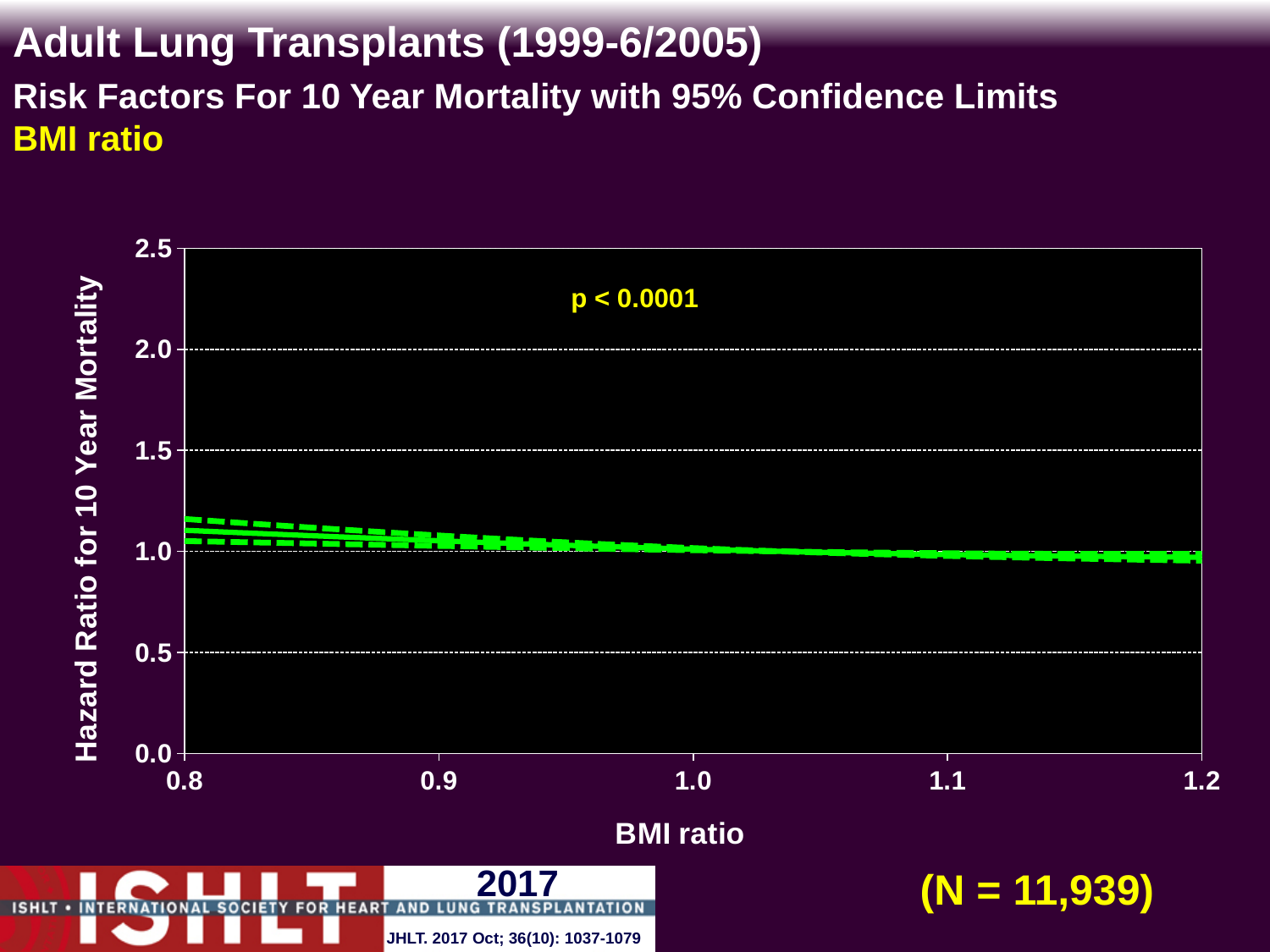
What is the lowest BMI ratio shown on the x axis? 0.8 What is the label of the y axis? Hazard Ratio for 10 Year Mortality Is the hazard ratio at a BMI ratio of 0.8 larger or smaller than at a BMI ratio of 1.2? larger Is the hazard ratio at a BMI ratio of 0.8 greater or less than 1.5? less Is the hazard ratio at a BMI ratio of 1.1 greater or less than 0.5? greater Is the hazard ratio at a BMI ratio of 1.2 greater or less than 1.5? less Does the hazard ratio rise or fall as the BMI ratio increases from 0.8 to 1.2? fall What is the label of the x axis? BMI ratio How many lines are plotted on the chart (the estimate plus its confidence limits)? 3 What kind of chart is shown on the slide? line chart